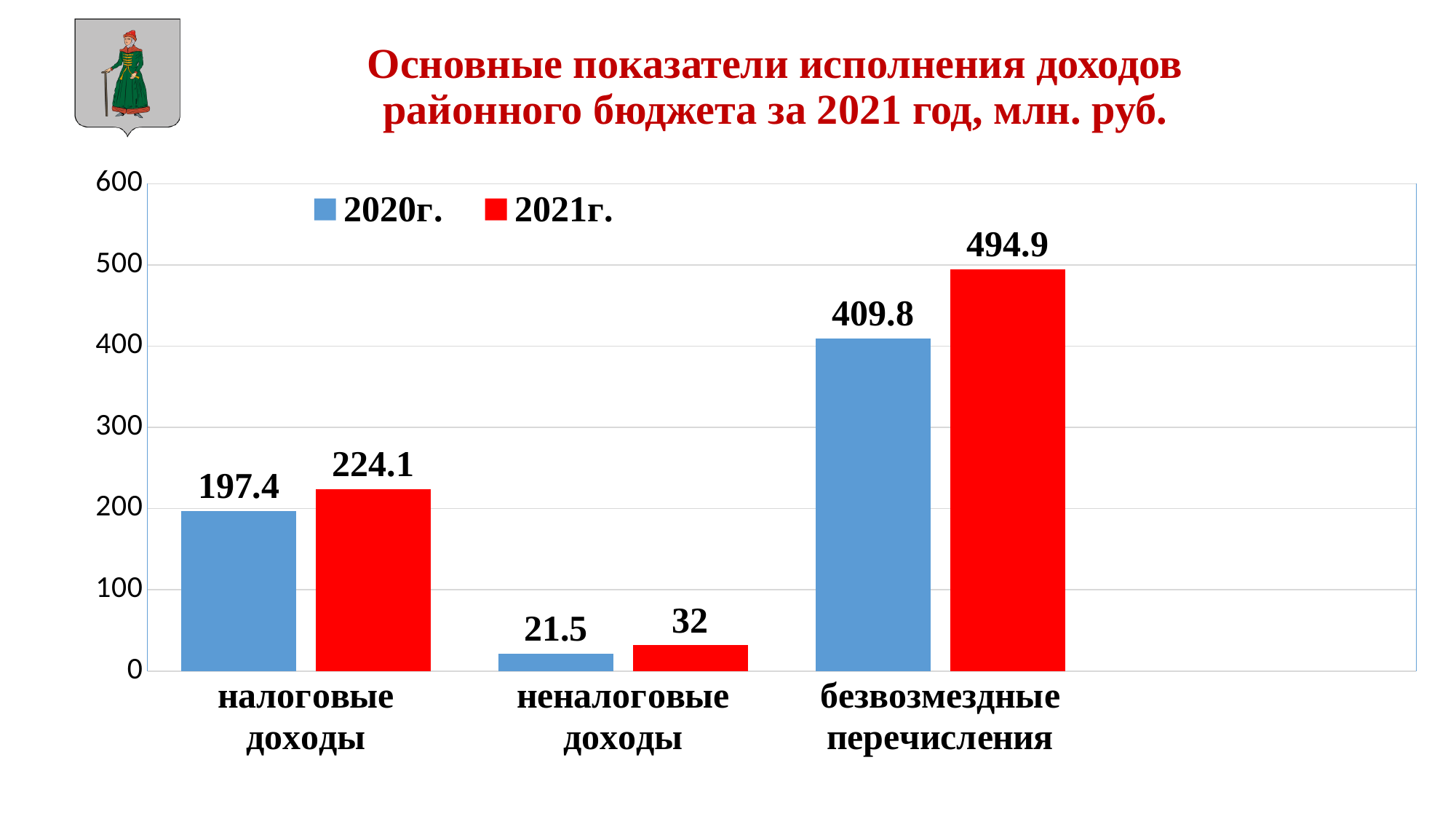
What is the difference between the 2021г. and 2020г. values for безвозмездные перечисления? 85.1 How many categories are shown on the x axis? 3 Which is larger for неналоговые доходы: the 2020г. value or the 2021г. value? 2021г. Which category has the lowest value in 2021г.? неналоговые доходы How many series does the legend list? 2 What is the value for неналоговые доходы in 2020г.? 21.5 What is the value for налоговые доходы in 2021г.? 224.1 Is the 2020г. value for налоговые доходы greater or less than 200? less What is the value for безвозмездные перечисления in 2021г.? 494.9 What kind of chart is shown on the slide? bar chart What is the difference between the 2021г. and 2020г. values for налоговые доходы? 26.7 Which category has the highest value in 2020г.? безвозмездные перечисления